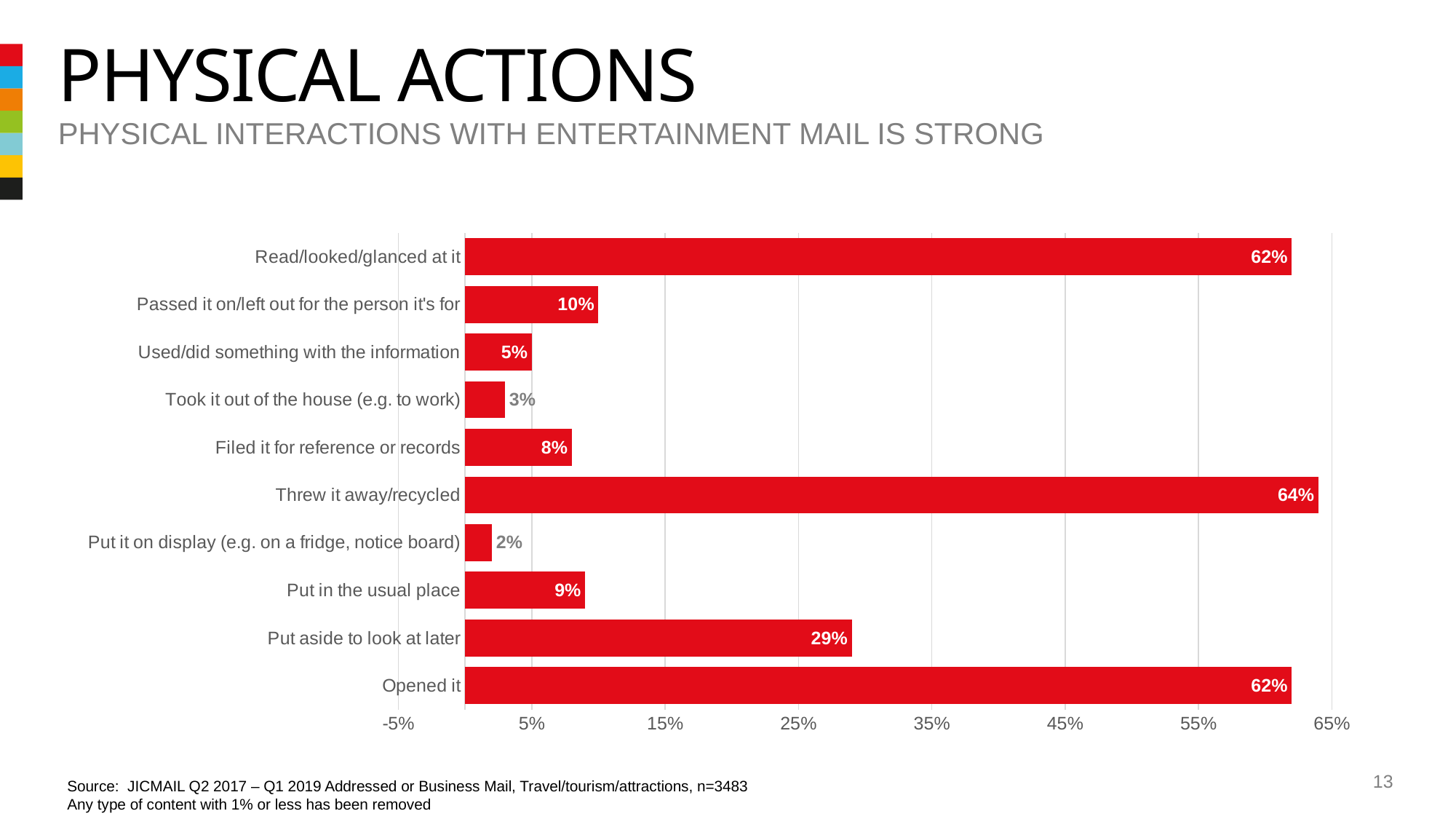
Which category has the highest value? Threw it away/recycled What is the value for "Passed it on/left out for the person it's for"? 10% What colour are the bars in the chart? Red What is the value for "Filed it for reference or records"? 8% What is the value for "Threw it away/recycled"? 64% What is the difference between "Passed it on/left out for the person it's for" and "Took it out of the house (e.g. to work)"? 7% What is the value for "Put aside to look at later"? 29% What is the difference between "Threw it away/recycled" and "Put aside to look at later"? 35% Which category has the lowest value? Put it on display (e.g. on a fridge, notice board) Which is larger: "Put in the usual place" or "Used/did something with the information"? Put in the usual place What kind of chart is shown on the slide? Bar chart How many categories are shown in the chart? 10